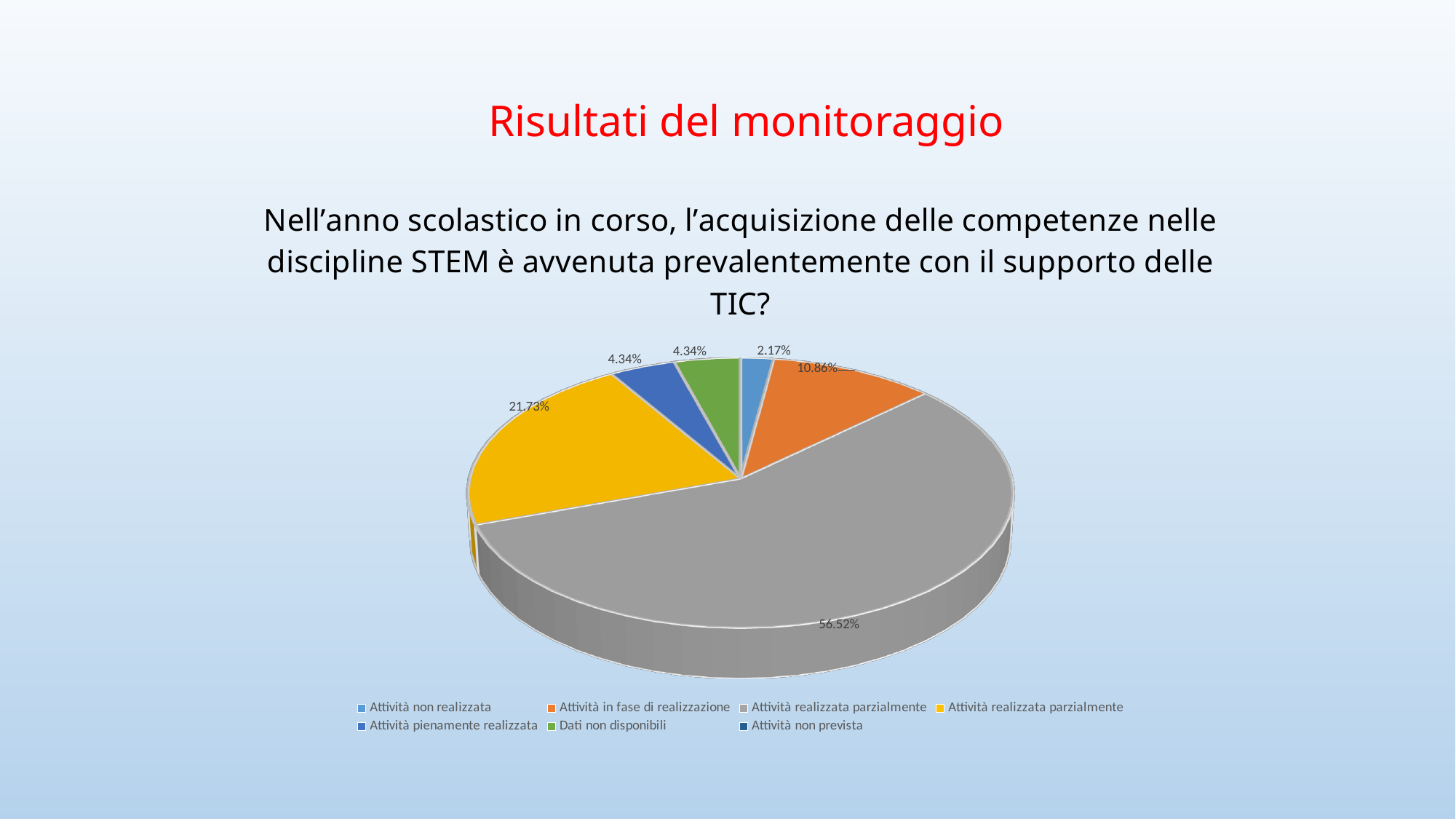
What is the percentage shown on the largest slice of the pie chart? 56.52% What percentage is shown for 'Attività non realizzata'? 2.17% How many entries does the legend of the pie chart list? 7 What is the difference in percentage points between 'Attività in fase di realizzazione' and 'Attività non realizzata'? 8.69 Which category has the smallest slice in the pie chart? Attività non realizzata What percentage is shown for 'Attività pienamente realizzata'? 4.34% What is the difference in percentage points between the gray slice (56.52%) and the yellow slice (21.73%)? 34.79 What kind of chart is shown on the slide? Pie chart Which is larger: the slice for 'Attività in fase di realizzazione' or the slice for 'Attività pienamente realizzata'? Attività in fase di realizzazione What percentage is shown for 'Dati non disponibili'? 4.34% How many slices with data labels are visible in the pie chart? 6 What percentage is shown for 'Attività in fase di realizzazione'? 10.86%